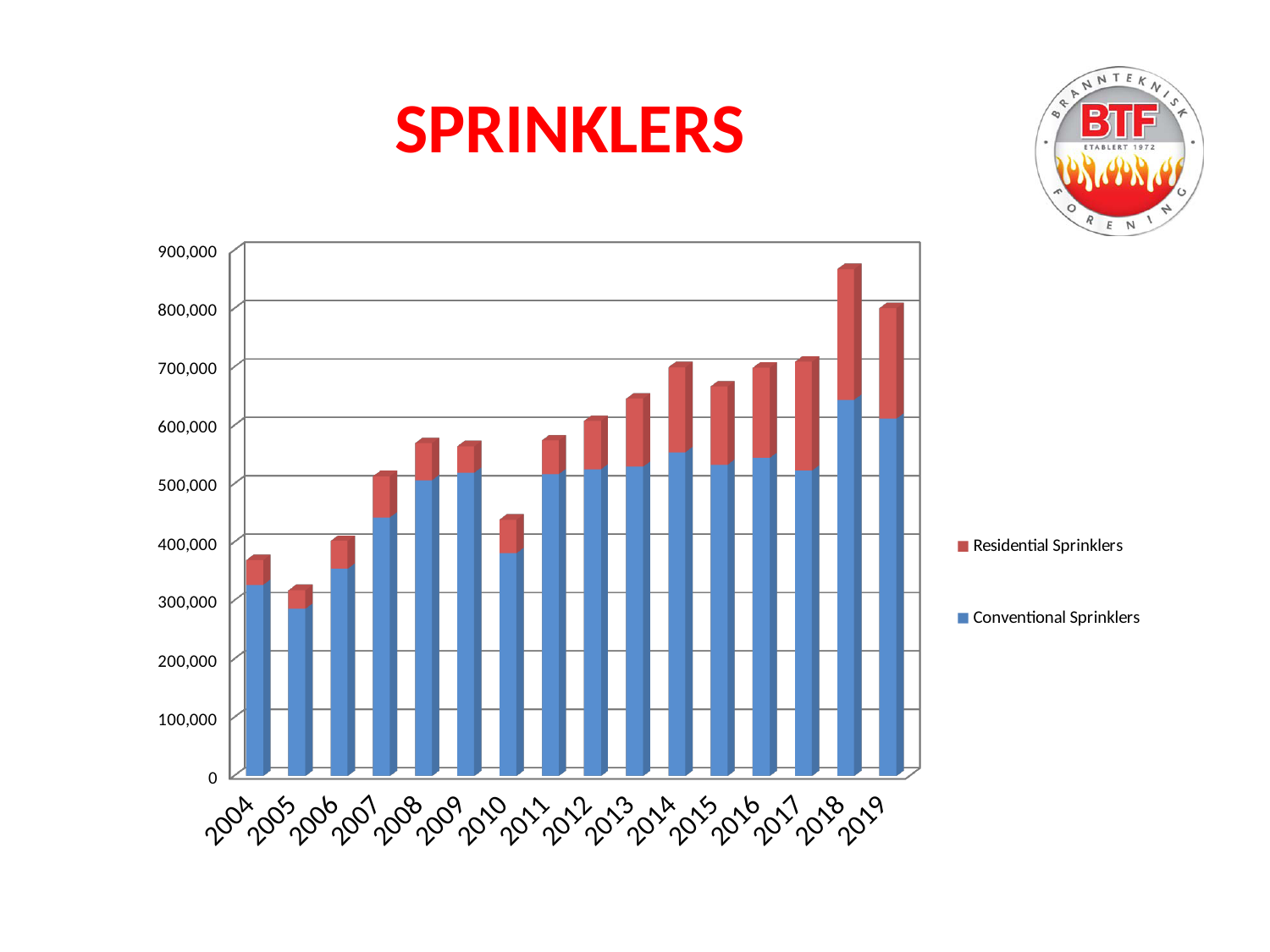
Is the Conventional Sprinklers value for 2010 greater or less than 400,000? less Is the total value for 2005 greater or less than 400,000? less How many series does the chart's legend list? 2 Which series is shown in red in the chart? Residential Sprinklers Is the Conventional Sprinklers value for 2018 greater or less than 600,000? greater How many years are shown on the x axis of the chart? 16 Which year has the highest total bar in the chart? 2018 Which year has the larger total bar, 2018 or 2019? 2018 What kind of chart is shown on the slide? stacked bar chart Which year has the lowest total bar in the chart? 2005 Which year has the larger total bar, 2009 or 2010? 2009